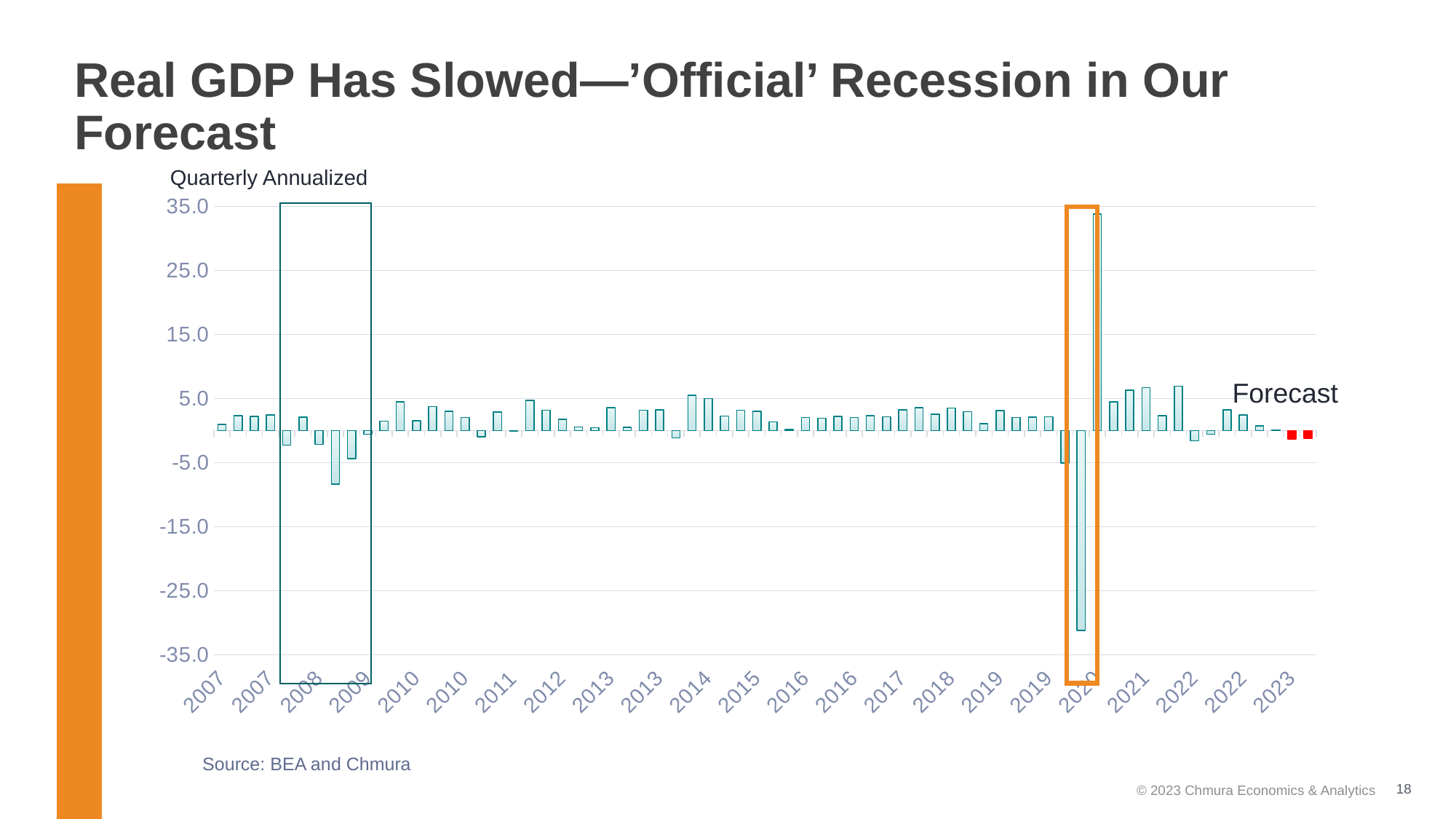
Is the value of the lowest bar inside the 2008–2009 box greater or less than -5.0? less In which year does the lowest (most negative) bar on the chart occur? 2020 Is the value of the tallest bar in 2020 greater or less than 25.0? greater Is the value of the lowest bar in 2020 greater or less than -25.0? less How many red forecast bars are shown at the right end of the chart? 2 What kind of chart is shown on the slide? bar chart What source is cited below the chart? BEA and Chmura In which year does the tallest bar on the chart occur? 2020 What is the highest value shown on the vertical axis? 35.0 What is the title printed above the chart? Quarterly Annualized Which is larger: the tallest bar in 2020 or the tallest bar in 2021? 2020